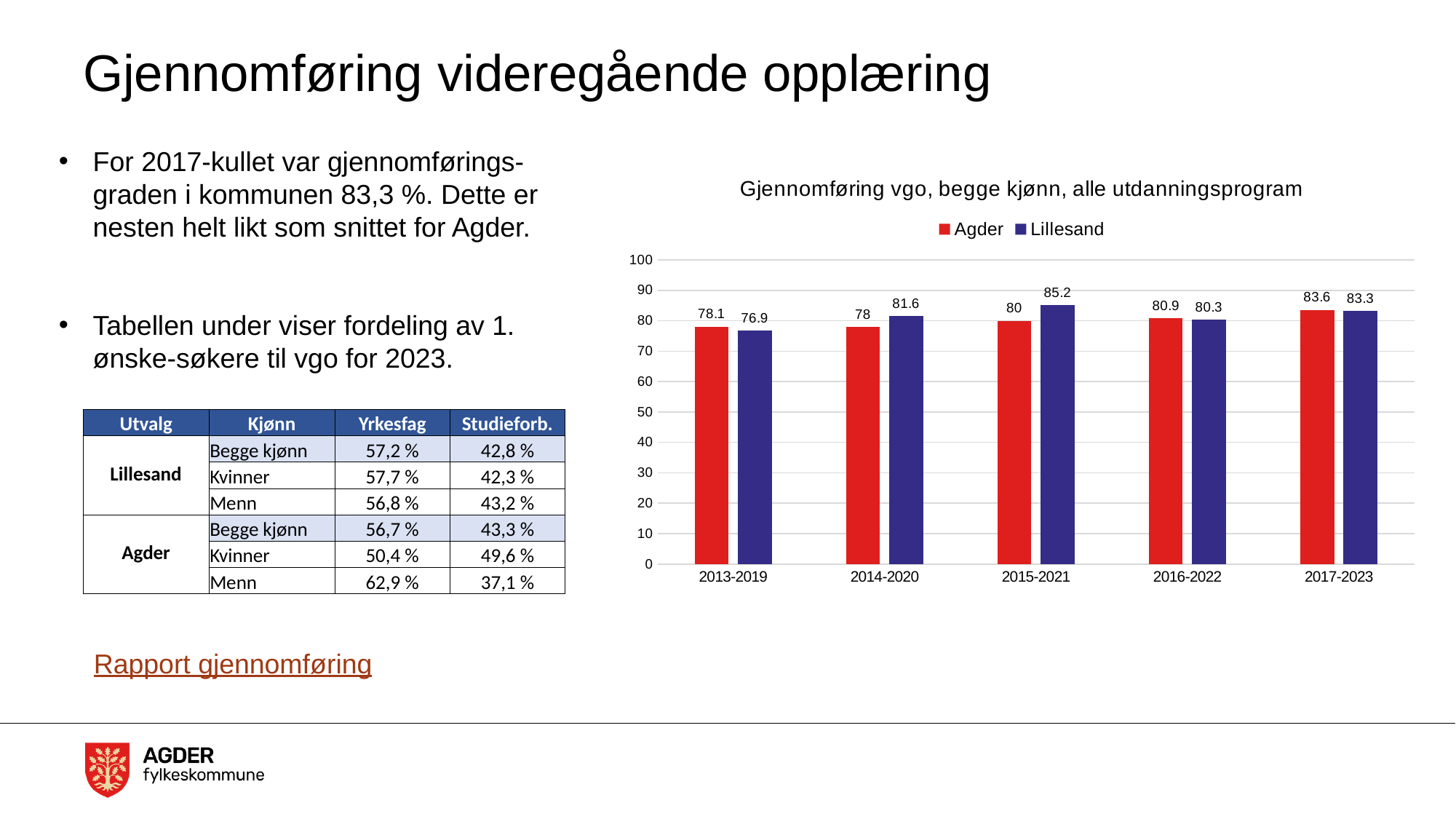
How many series does the legend list? 2 Which is larger in 2013-2019, Agder or Lillesand? Agder What is the value for Agder in 2013-2019? 78.1 How many periods are shown on the x axis? 5 Is the value for Lillesand in 2014-2020 greater or less than 80? greater What kind of chart is shown? Bar chart Which period has the highest value for Lillesand? 2015-2021 Which period has the lowest value for Agder? 2014-2020 What is the title of the chart? Gjennomføring vgo, begge kjønn, alle utdanningsprogram What is the difference between Lillesand and Agder in 2015-2021? 5.2 What is the value for Lillesand in 2017-2023? 83.3 What is the value for Lillesand in 2015-2021? 85.2